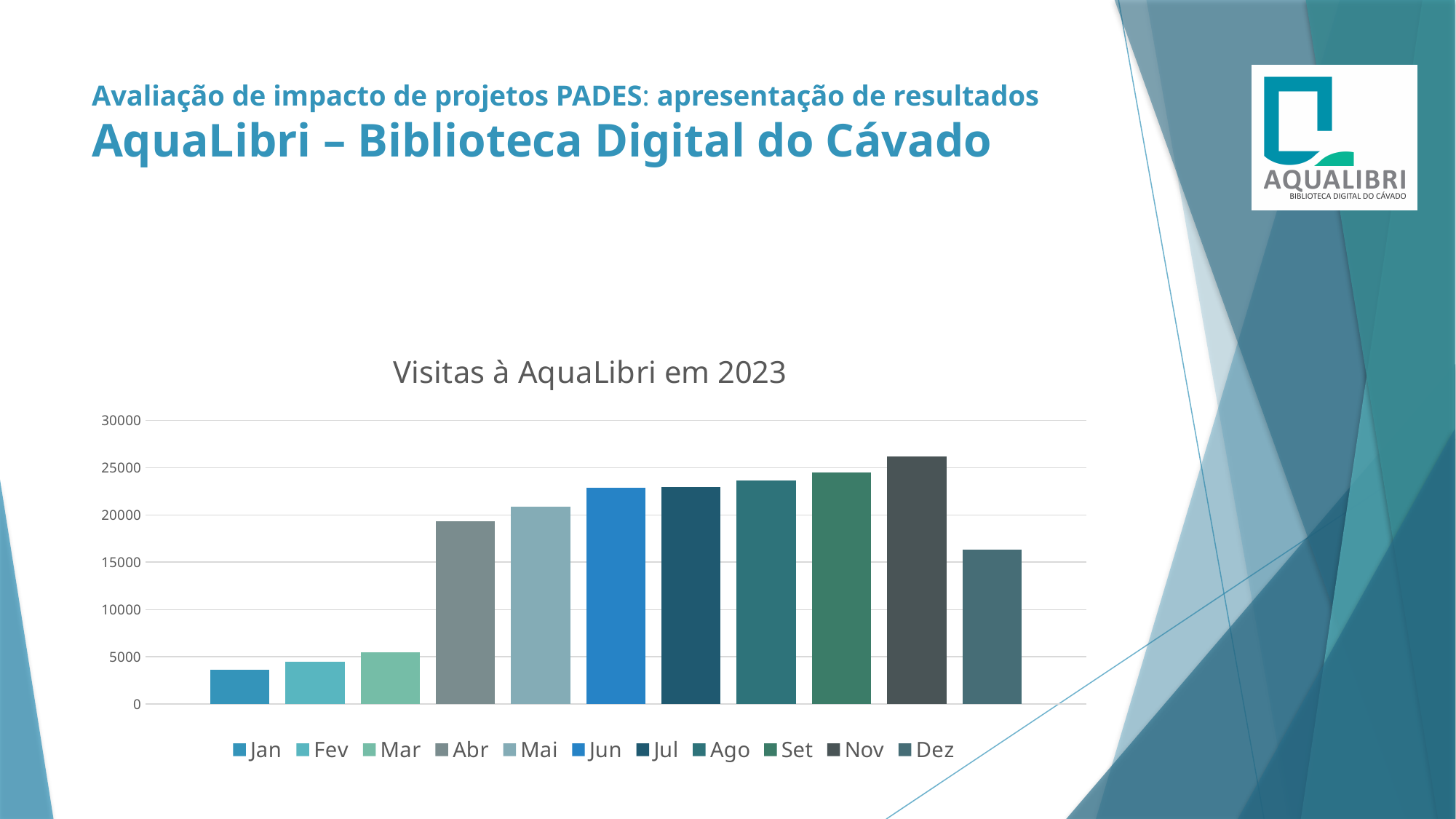
Is the value for Jan greater or less than 5000? less Is the value for Abr greater or less than 20000? less What is the title of the chart? Visitas à AquaLibri em 2023 Is the value for Dez greater or less than 15000? greater Which month has the highest number of visits in the chart? Nov Do the visits generally rise or fall from Jan to Nov? rise Which month has the lowest number of visits in the chart? Jan Which has more visits, Mar or Mai? Mai Which has more visits, Abr or Dez? Abr How many entries does the chart legend list? 11 What kind of chart is shown on the slide? bar chart